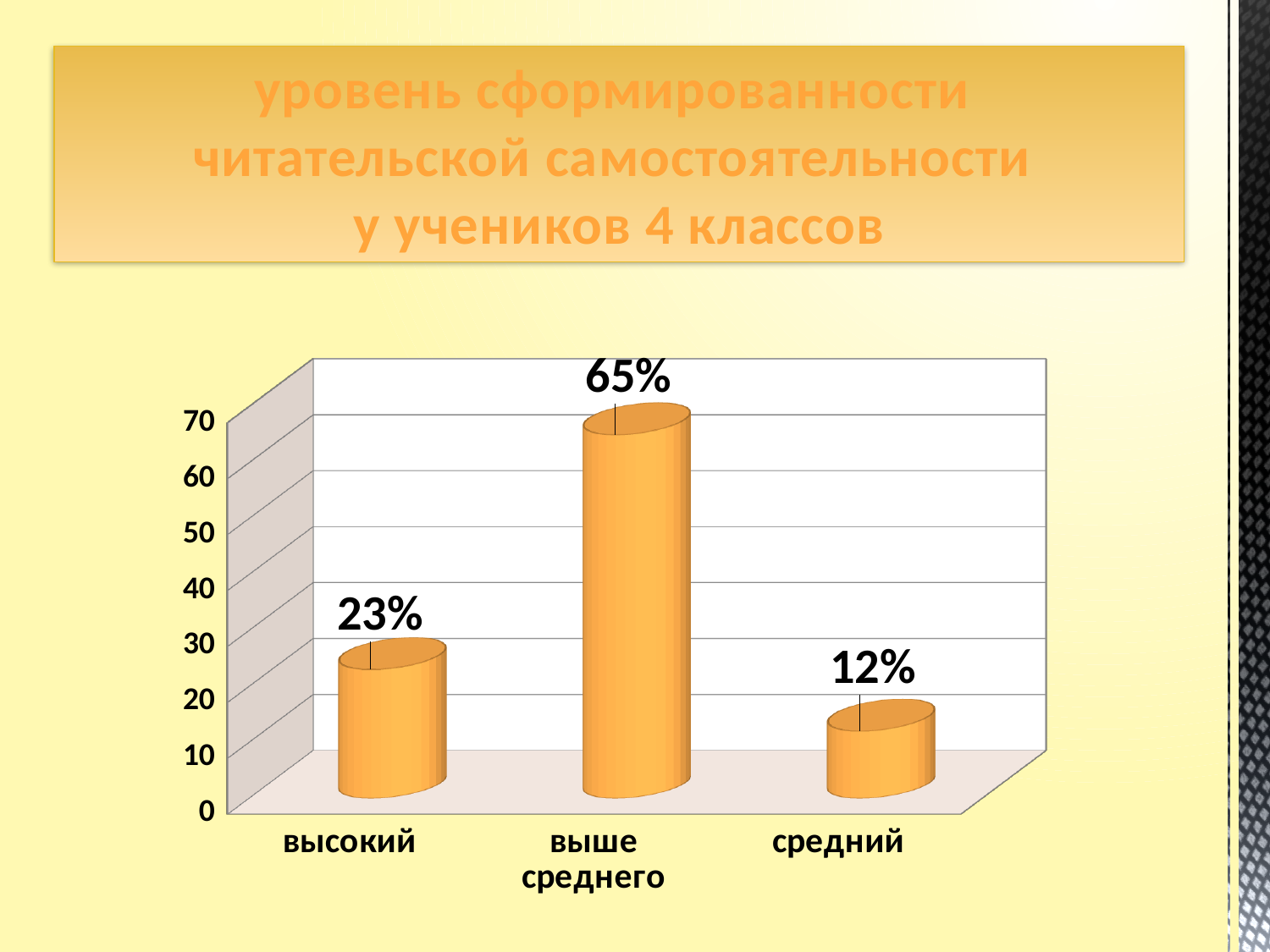
Is the value for 'выше среднего' greater or less than 60? greater What is the title of the slide above the chart? уровень сформированности читательской самостоятельности у учеников 4 классов What is the value for the 'выше среднего' category? 65% What is the value for the 'высокий' category? 23% Which category has the lowest value? средний What kind of chart is shown on the slide? bar chart What is the difference between the values for 'выше среднего' and 'высокий'? 42% Which category has the highest value? выше среднего Which is larger, the value for 'высокий' or the value for 'средний'? высокий What is the difference between the values for 'высокий' and 'средний'? 11% How many categories are shown on the x axis? 3 What is the value for the 'средний' category? 12%